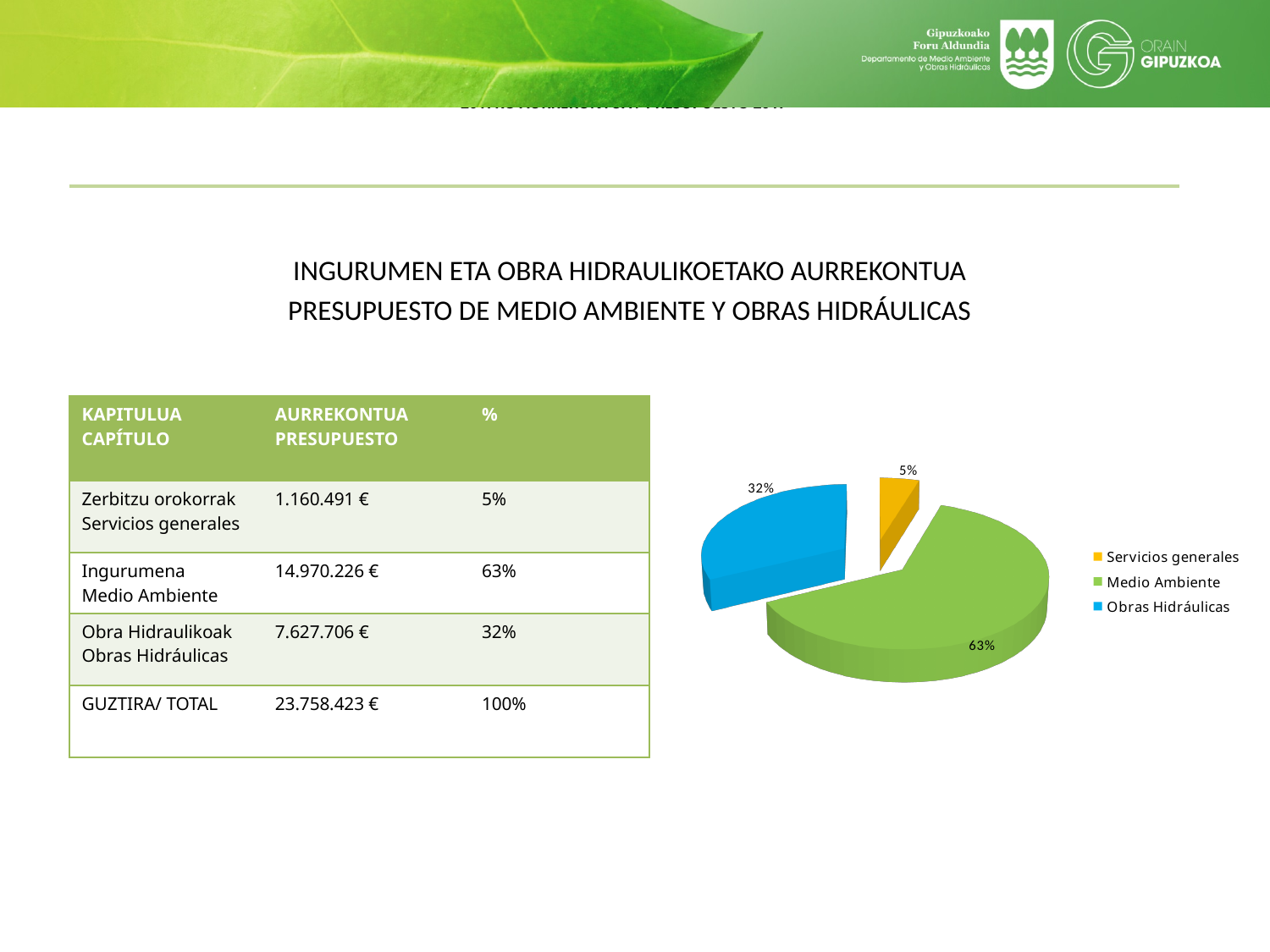
What share of the pie does Obras Hidráulicas represent? 32% What share of the pie does Servicios generales represent? 5% What kind of chart is shown on the slide? pie chart What is the difference in percentage points between the Medio Ambiente slice and the Obras Hidráulicas slice? 31 Which slice of the pie chart is the largest? Medio Ambiente What share of the pie does Medio Ambiente represent? 63% Which is larger in the pie chart, Obras Hidráulicas or Servicios generales? Obras Hidráulicas How many entries does the legend of the pie chart list? 3 What colour is the Servicios generales slice in the pie chart? yellow How many slices does the pie chart have? 3 Which slice of the pie chart is the smallest? Servicios generales What colour is the Obras Hidráulicas slice in the pie chart? blue